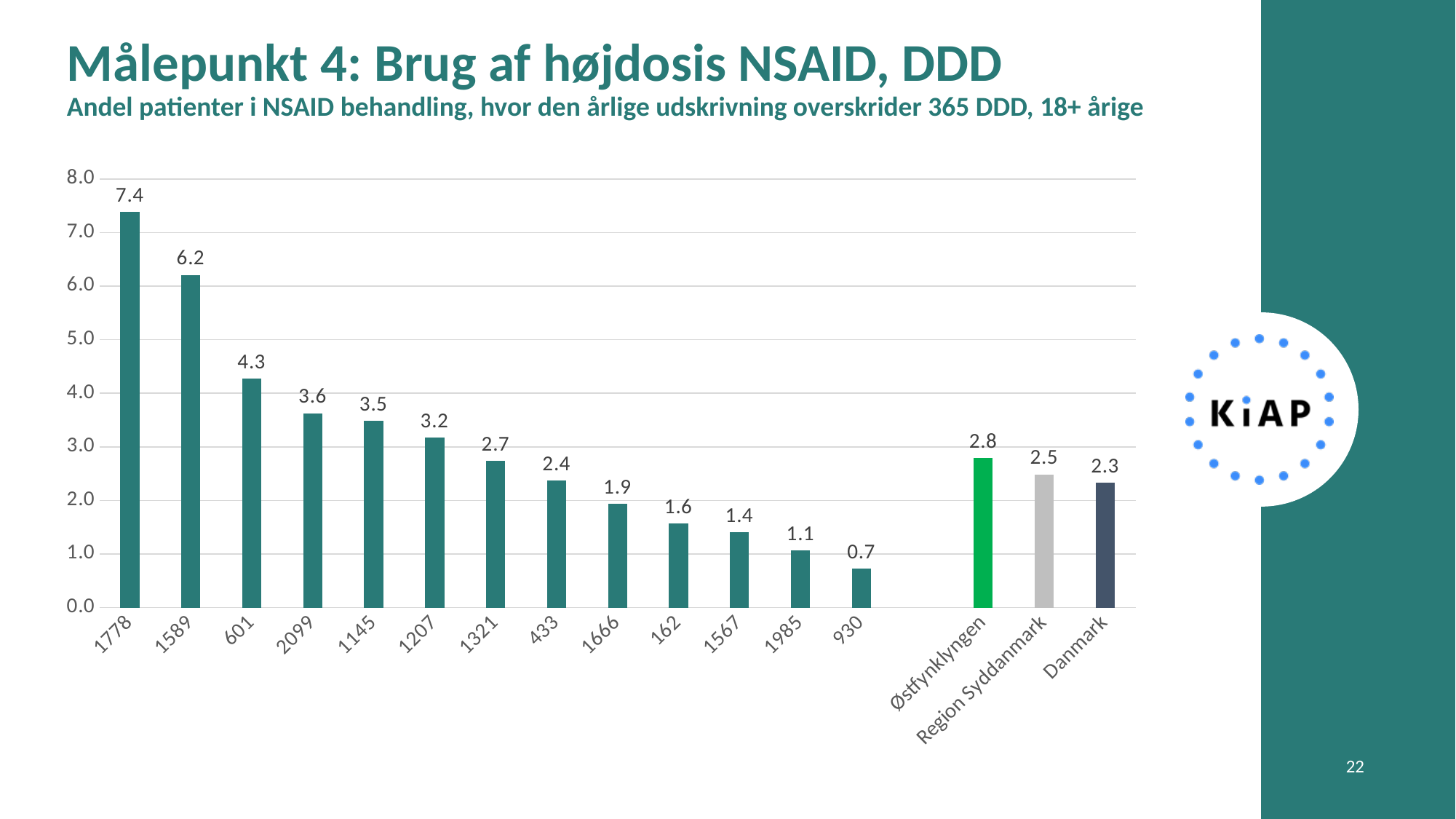
What is the difference between the values for Østfynklyngen and Danmark? 0.5 What is the value for Østfynklyngen? 2.8 Which is larger, the value for 601 or the value for 2099? 601 What kind of chart is shown on the slide? Bar chart What is the value for Danmark? 2.3 What is the value for 1778? 7.4 Which category has the lowest value? 930 What is the value for Region Syddanmark? 2.5 Which category has the highest value? 1778 How many bars are shown in the chart? 16 What is the difference between the values for 1778 and 1589? 1.2 What is the title of the slide? Målepunkt 4: Brug af højdosis NSAID, DDD